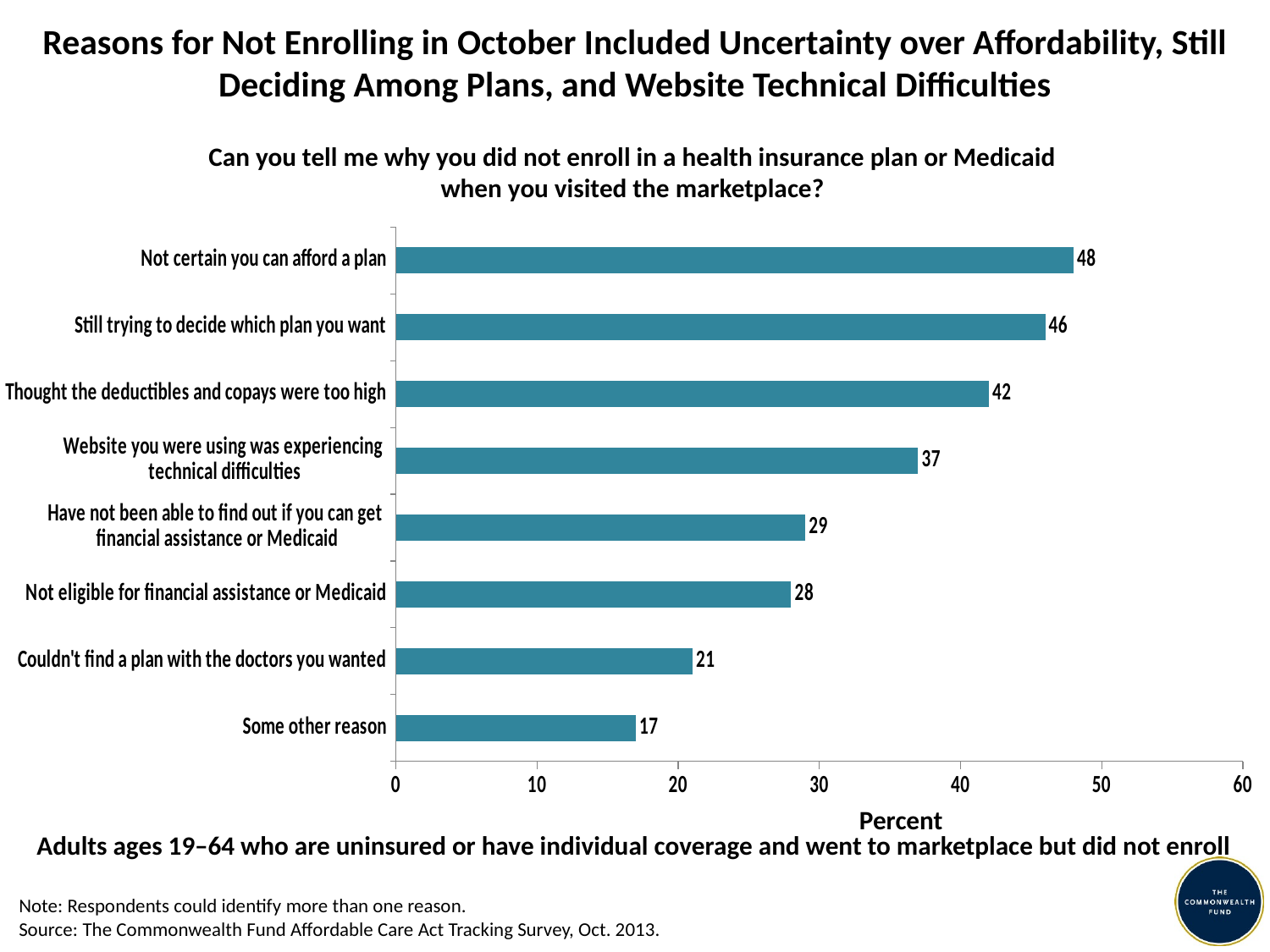
How many reasons are shown in the chart? 8 Is the value for 'Not eligible for financial assistance or Medicaid' greater or less than 30? less What is the label on the horizontal axis of the chart? Percent Which reason has the highest value? Not certain you can afford a plan Which reason has the lowest value? Some other reason What is the value for 'Website you were using was experiencing technical difficulties'? 37 What is the difference between 'Not certain you can afford a plan' and 'Still trying to decide which plan you want'? 2 What is the difference between 'Thought the deductibles and copays were too high' and 'Couldn't find a plan with the doctors you wanted'? 21 What percent cited 'Some other reason'? 17 Which is larger: 'Have not been able to find out if you can get financial assistance or Medicaid' or 'Couldn't find a plan with the doctors you wanted'? Have not been able to find out if you can get financial assistance or Medicaid What kind of chart is shown on the slide? bar chart What percent of respondents said they were not certain they could afford a plan? 48